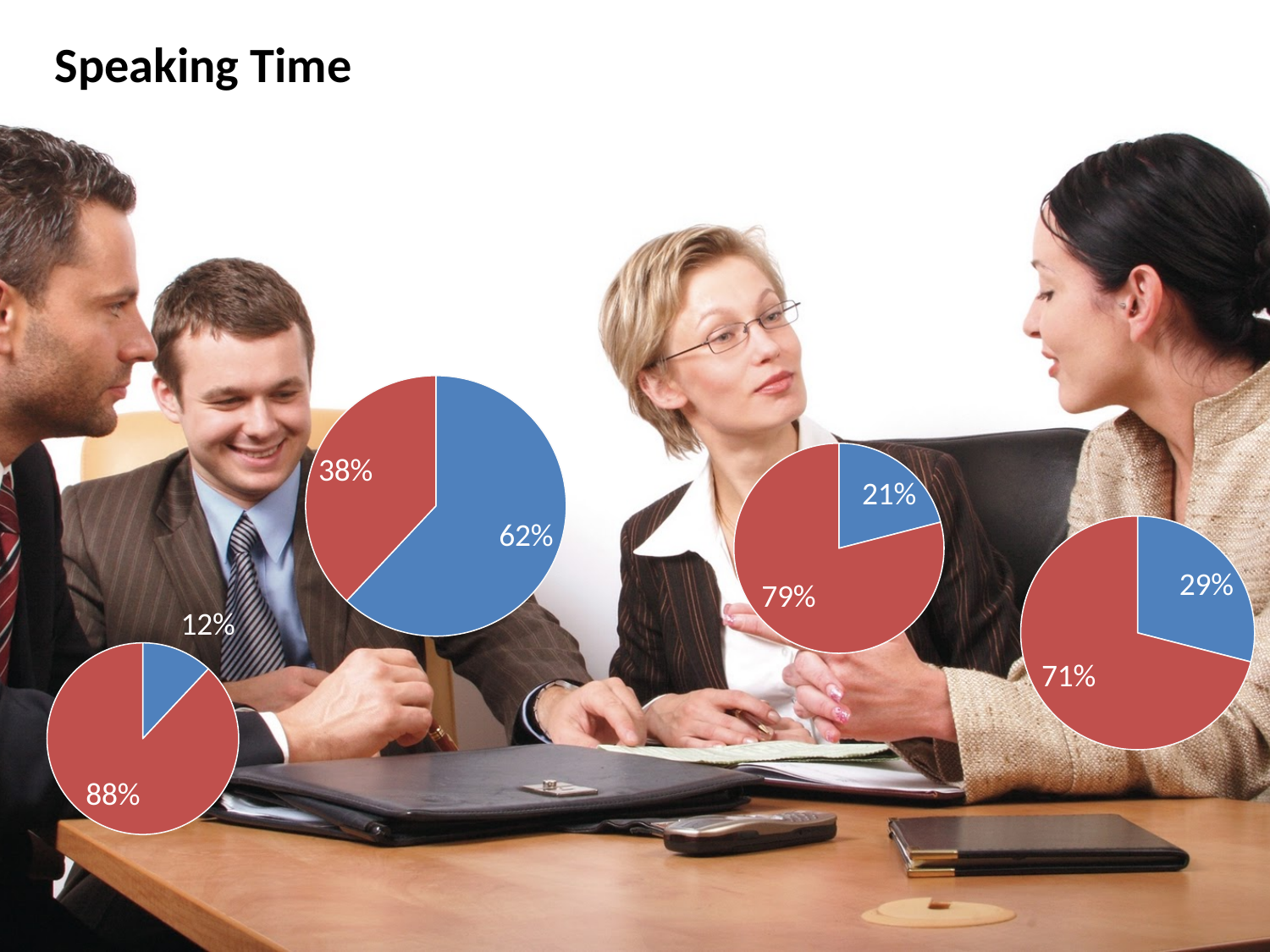
How many slices does each pie chart on the slide have? 2 In the far-right pie chart, what percentage does the red slice show? 71% In the bottom-left pie chart, what percentage does the blue slice show? 12% In the second pie chart from the left (the upper one), what percentage does the red slice show? 38% In the bottom-left pie chart, what percentage does the red slice show? 88% In the far-right pie chart, which slice is larger, the blue one or the red one? Red What kind of chart is used on the slide to show speaking time? Pie chart In the third pie chart from the left, what is the difference between the red slice and the blue slice? 58% In the third pie chart from the left, what percentage does the blue slice show? 21% In the second pie chart from the left (the upper one), what is the difference between the blue slice and the red slice? 24% How many pie charts are shown on the slide? 4 In the second pie chart from the left (the upper one), what percentage does the blue slice show? 62%